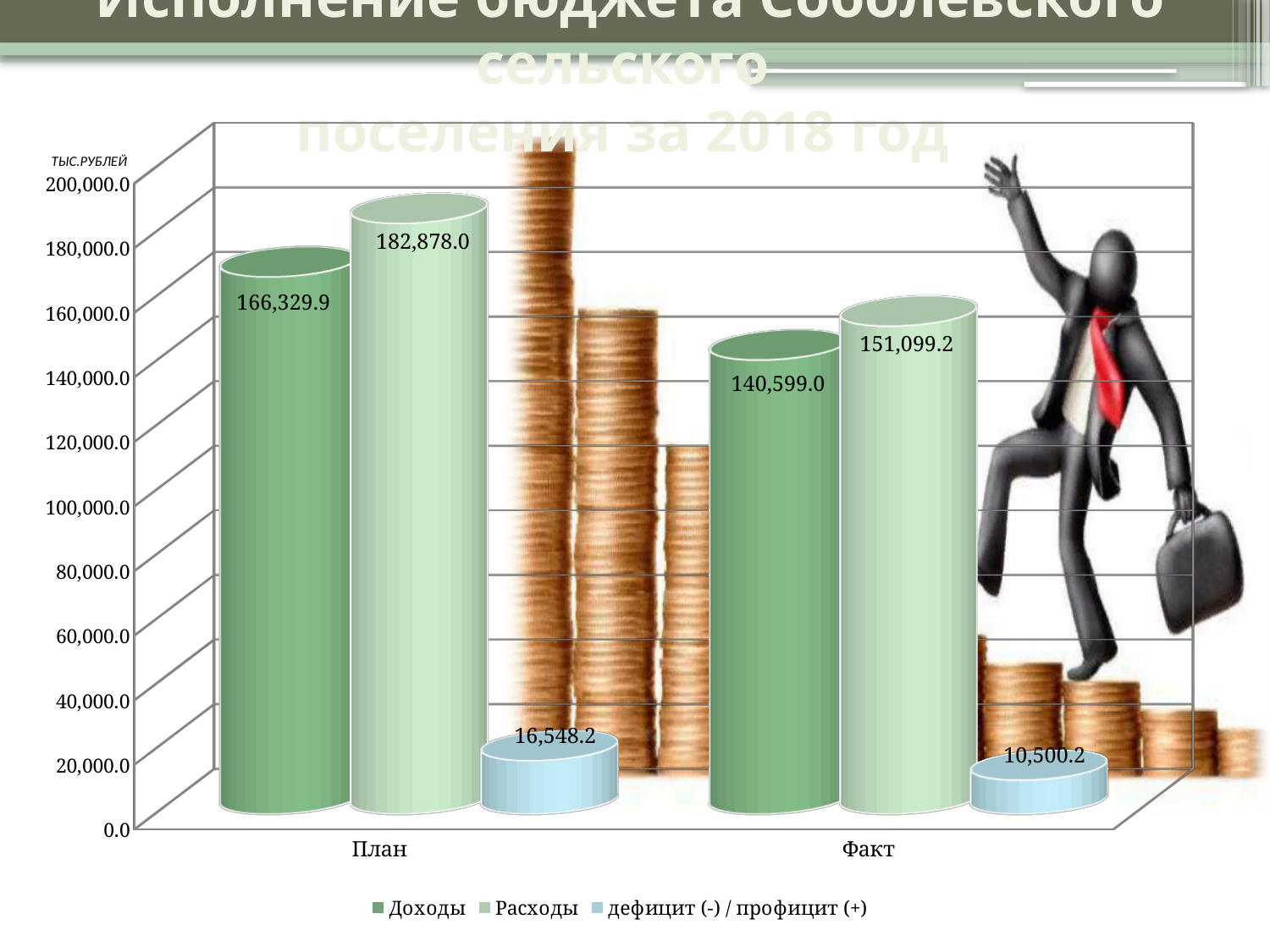
How many series does the legend list? 3 What is the value of Доходы for План? 166,329.9 Which series has the highest value in the План category? Расходы What is the value of Расходы for Факт? 151,099.2 What is the value of дефицит (-) / профицит (+) for План? 16,548.2 What is the value of Доходы for Факт? 140,599.0 Which is larger: Расходы for План or Расходы for Факт? Расходы for План How many categories are shown on the x axis? 2 What is the difference between Расходы for Факт and Доходы for Факт? 10,500.2 What is the difference between Доходы for План and Доходы for Факт? 25,730.9 What kind of chart is shown on the slide? Bar chart Which series has the lowest value in the Факт category? дефицит (-) / профицит (+)